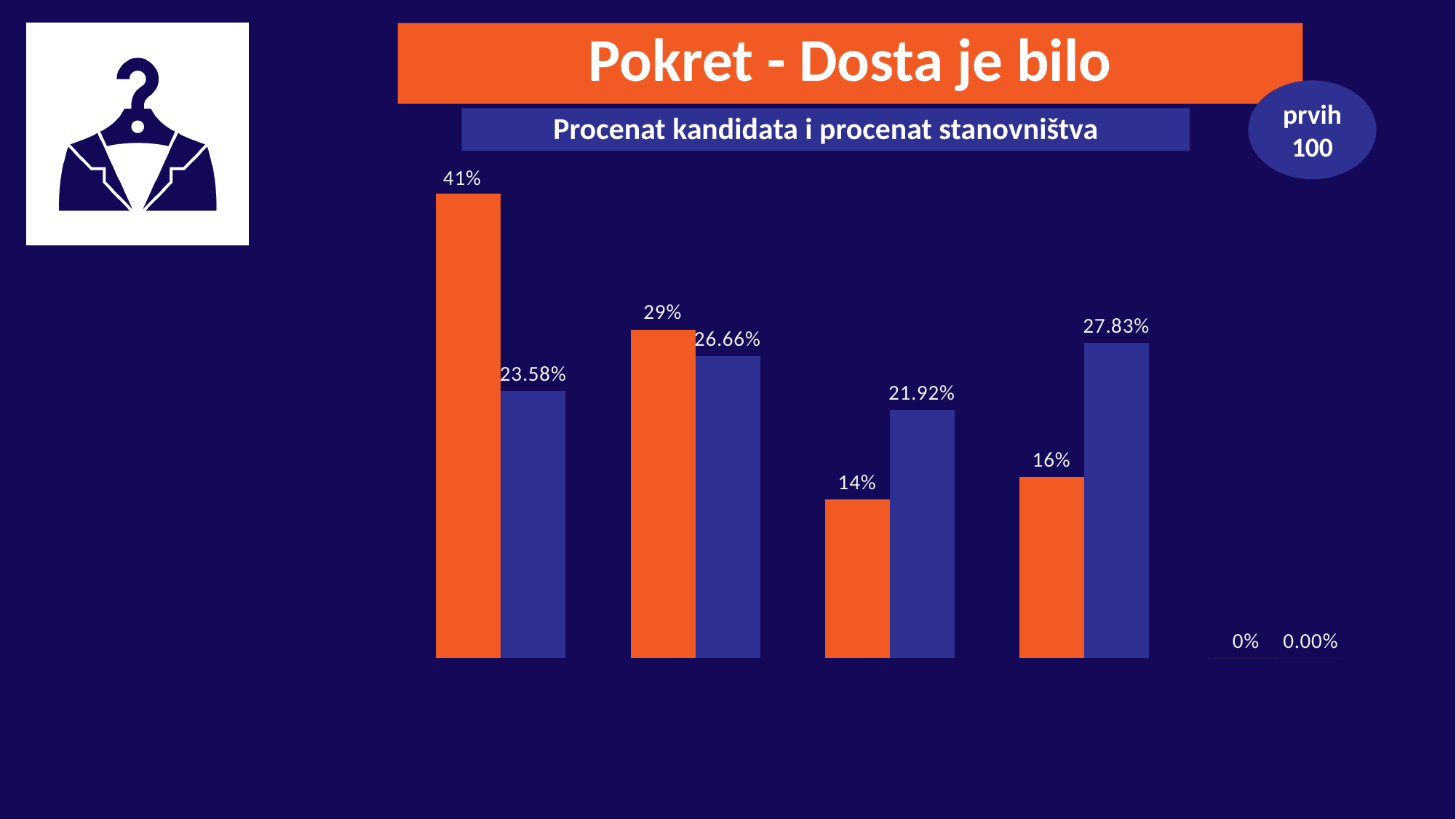
What is the value of the orange bar in the first (leftmost) group? 41% What is the subtitle shown in the blue banner above the chart? Procenat kandidata i procenat stanovništva How many groups of bars are plotted in the chart? 5 What kind of chart is shown on the slide? bar chart Which group has the highest orange bar? the first (leftmost) group What is the value of the blue bar in the first (leftmost) group? 23.58% In the third group from the left, which bar is larger, the orange or the blue? blue What is the difference between the orange bar and the blue bar in the first (leftmost) group? 17.42 percentage points Which group has the highest blue bar? the fourth group from the left What is the title shown in the orange banner above the chart? Pokret - Dosta je bilo What is the value of the orange bar in the third group from the left? 14% What is the value of the blue bar in the fourth group from the left? 27.83%